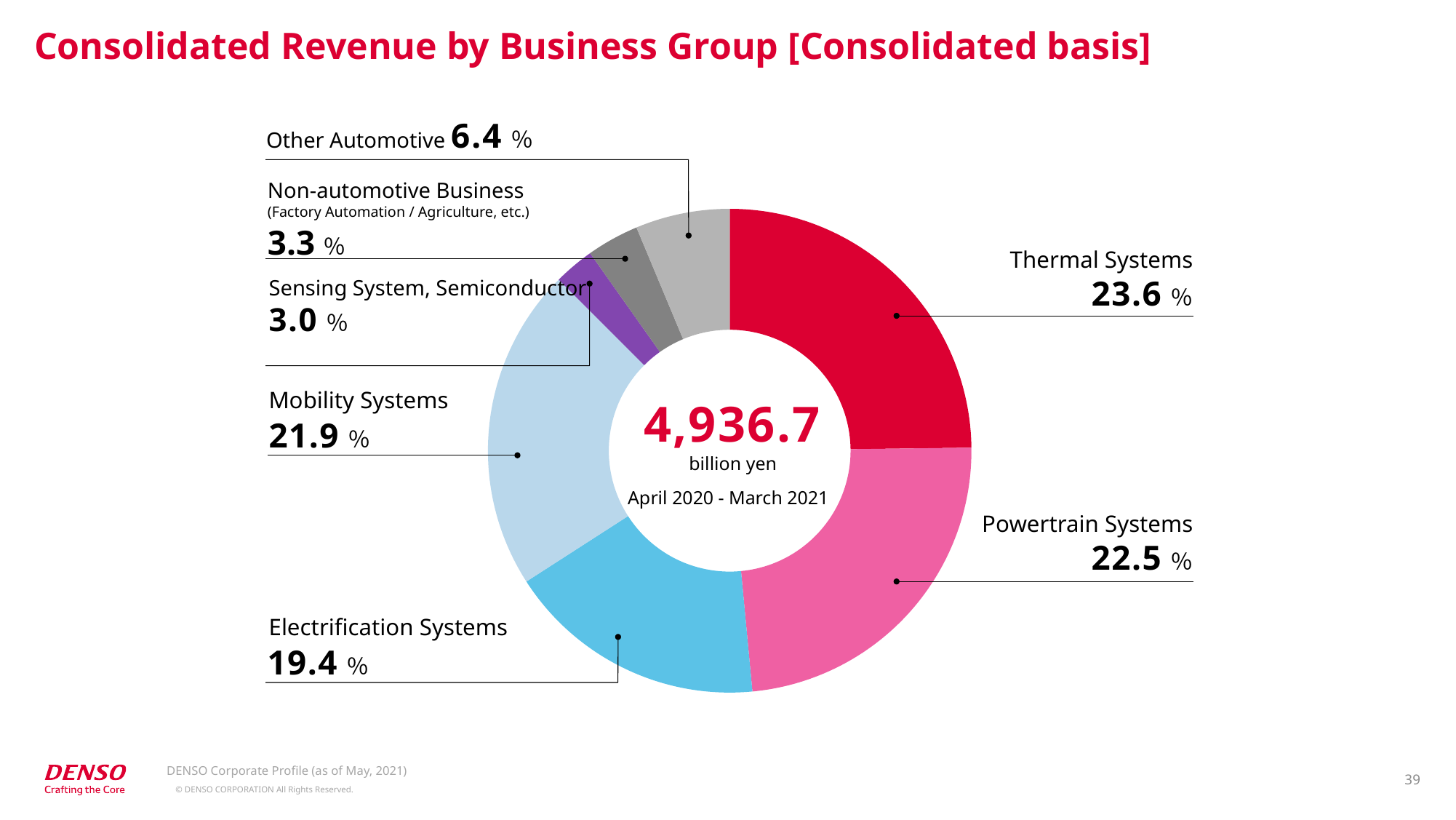
What share of consolidated revenue does Thermal Systems account for? 23.6% What share of consolidated revenue does Electrification Systems account for? 19.4% How many business groups are shown in the chart? 7 What share of consolidated revenue does Non-automotive Business account for? 3.3% What is the difference in percentage points between the Powertrain Systems share and the Mobility Systems share? 0.6 Which business group has the smallest share of consolidated revenue? Sensing System, Semiconductor What period does the chart cover? April 2020 - March 2021 What kind of chart is used to show consolidated revenue by business group? Pie chart (donut) Which business group has the largest share of consolidated revenue? Thermal Systems What is the combined share of Thermal Systems and Powertrain Systems? 46.1% What total consolidated revenue is shown in the centre of the chart? 4,936.7 billion yen Which has a larger share of consolidated revenue, Other Automotive or Non-automotive Business? Other Automotive